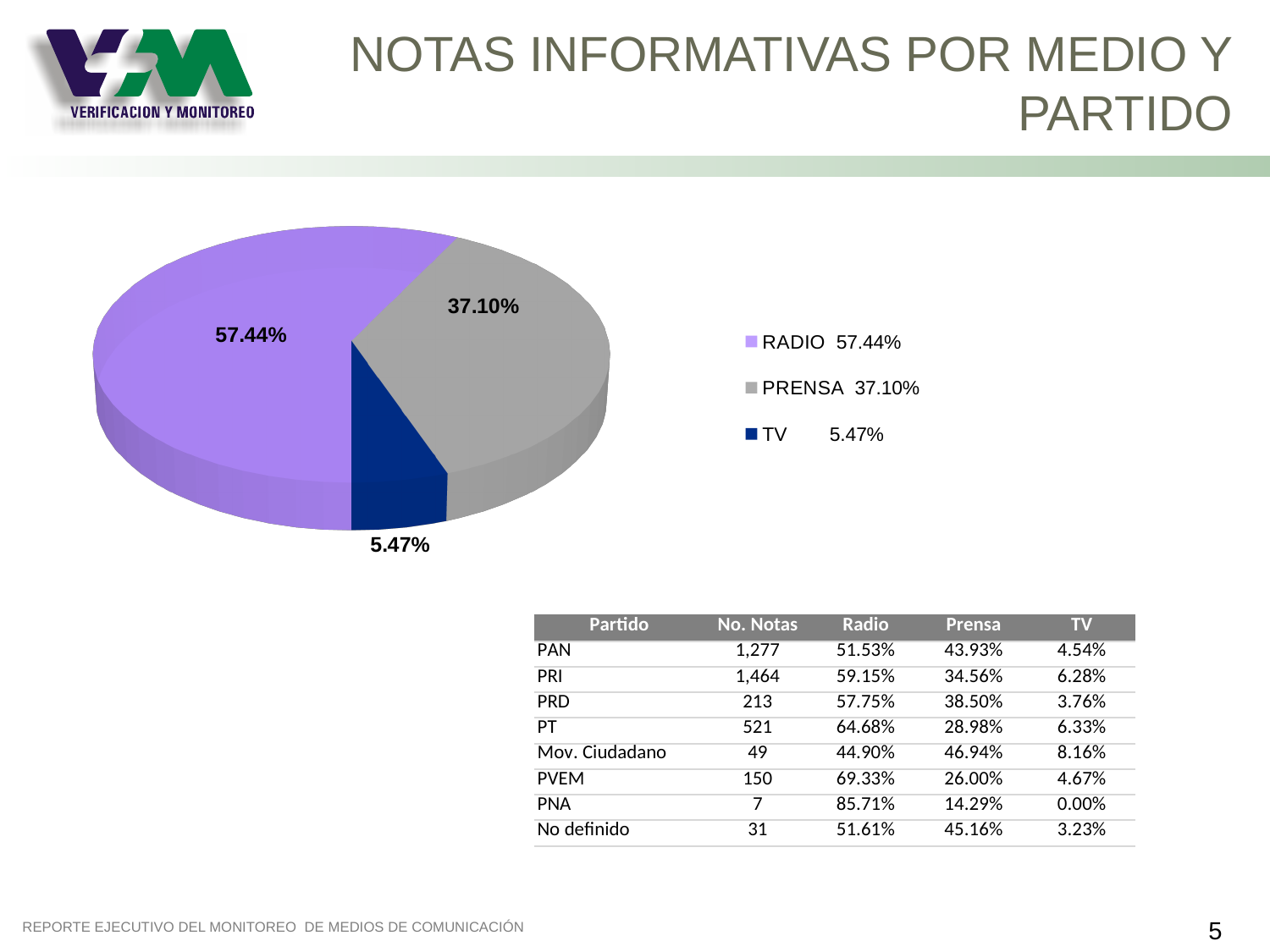
Which medium has the smallest slice of the pie? TV How many entries does the legend list? 3 What colour is the TV slice in the pie chart? dark blue What kind of chart is shown on the slide? pie chart Which slice is larger, PRENSA or TV? PRENSA What colour is the RADIO slice in the pie chart? purple What share of the pie does TV have? 5.47% Which medium has the largest slice of the pie? RADIO What share of the pie does PRENSA have? 37.10% What share of the pie does RADIO have? 57.44% What is the difference in percentage points between the RADIO and PRENSA slices? 20.34 How many slices does the pie chart have? 3